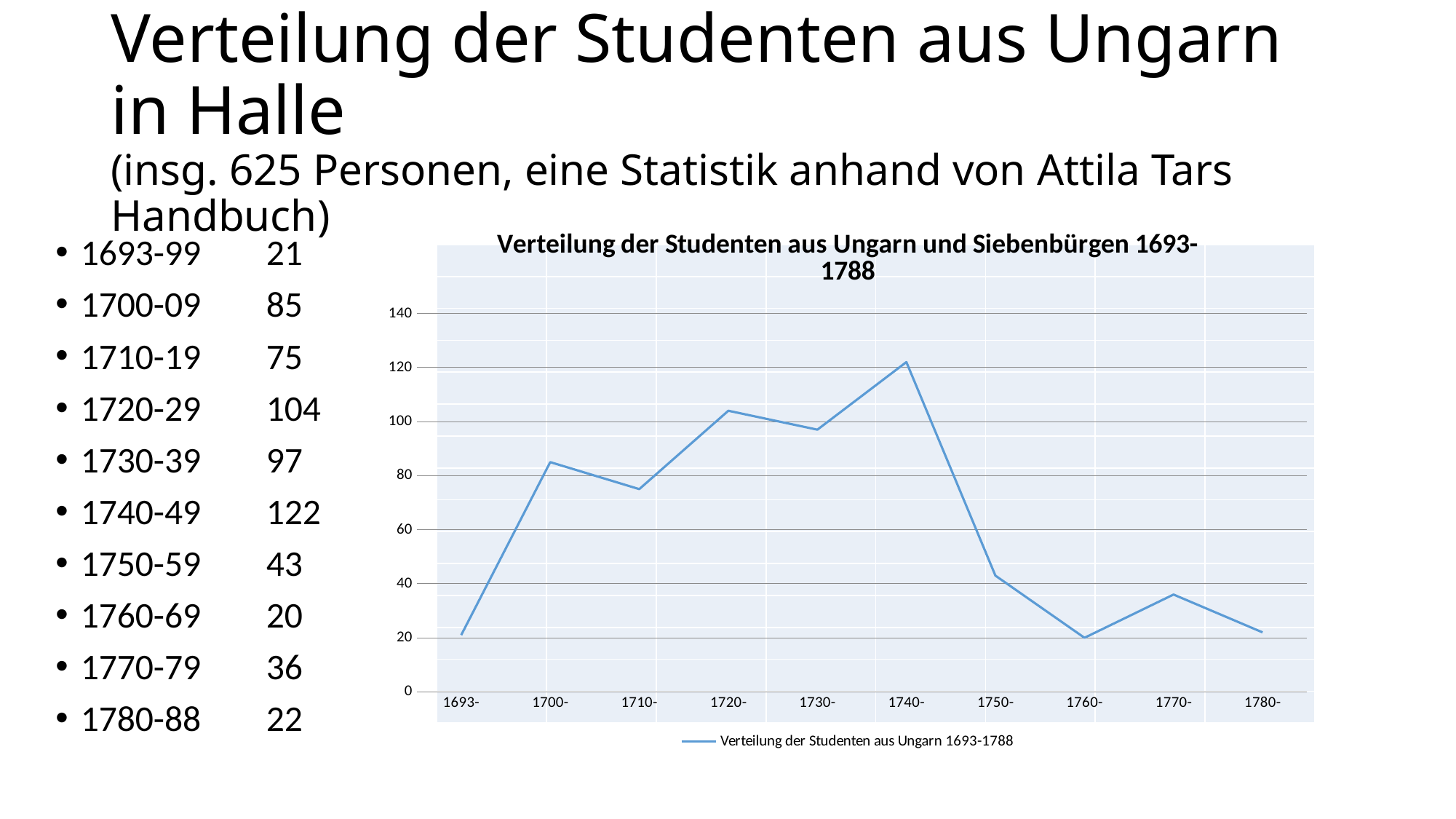
How many series does the chart legend list? 1 What is the value for 1740-49 according to the slide? 122 Is the value for 1720- greater or less than 100? greater What is the value for 1720-29 according to the slide? 104 How many points (decades) are plotted along the x axis of the chart? 10 What kind of chart is shown on the slide? line chart Which decade has the highest value in the chart? 1740- What is the difference between the values for 1740-49 and 1750-59? 79 Which is larger, the value for 1700-09 or the value for 1710-19? 1700-09 What is the title of the chart? Verteilung der Studenten aus Ungarn und Siebenbürgen 1693-1788 Does the line rise or fall between 1740- and 1760-? fall Is the value for 1770- greater or less than 40? less